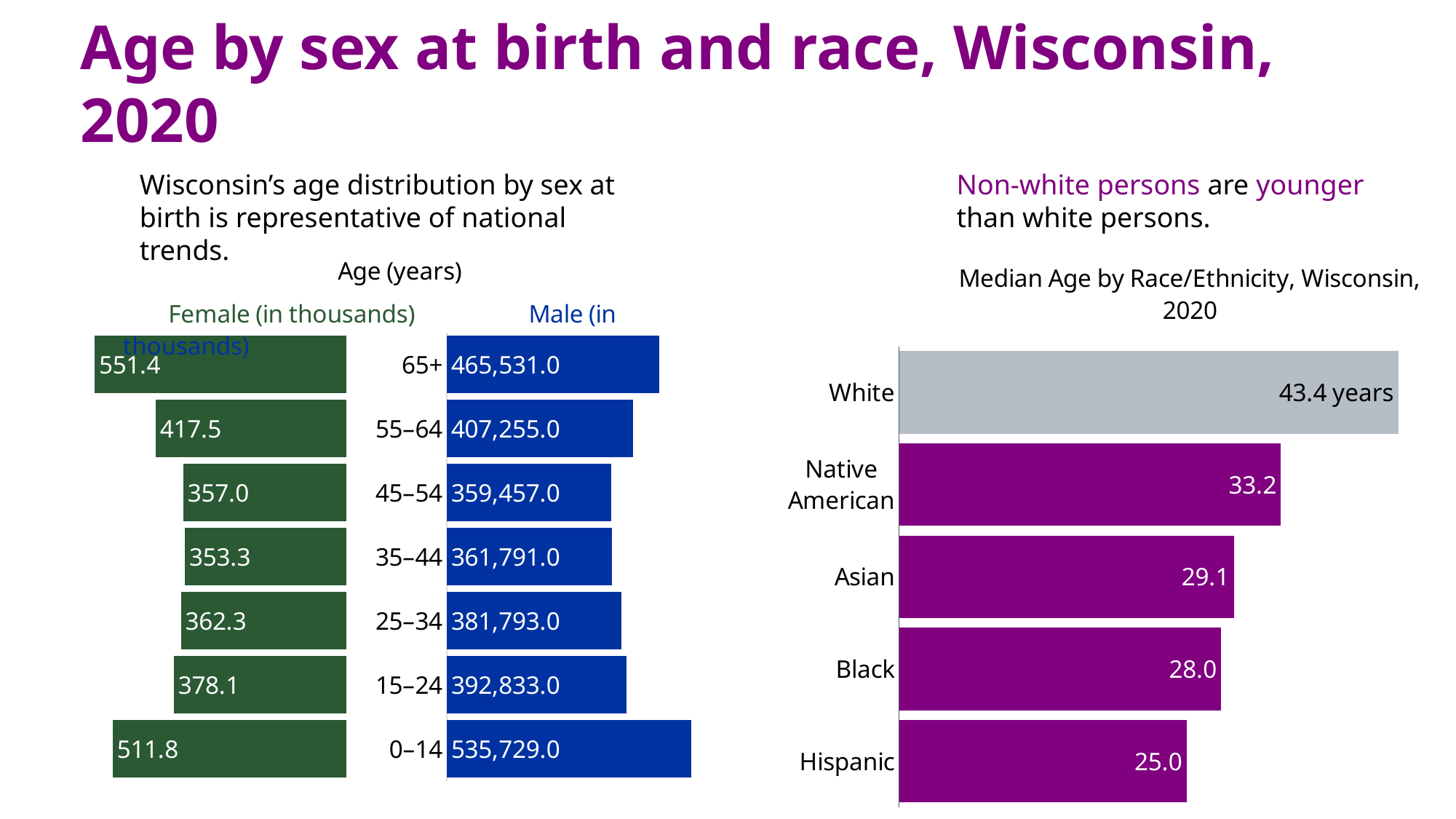
In the age distribution chart on the left, which age group has the highest Male value? 0–14 In the age distribution chart on the left, which age group has the highest Female value? 65+ In the age distribution chart on the left, what is the Male value for the 0–14 age group? 535,729.0 In the age distribution chart on the left, which age group has the lowest Female value? 35–44 How many age groups are shown in the age distribution chart on the left? 7 In the age distribution chart on the left, what is the Female value (in thousands) for the 65+ age group? 551.4 What kind of chart is the Median Age by Race/Ethnicity chart? Bar chart In the age distribution chart on the left, what is the difference between the Female values for the 65+ and 0–14 age groups? 39.6 In the Median Age by Race/Ethnicity chart, what is the difference between the median ages of White and Hispanic persons? 18.4 years In the Median Age by Race/Ethnicity chart, what is the median age for Asian persons? 29.1 In the Median Age by Race/Ethnicity chart, which group has the highest median age? White In the Median Age by Race/Ethnicity chart, which group has the lowest median age? Hispanic